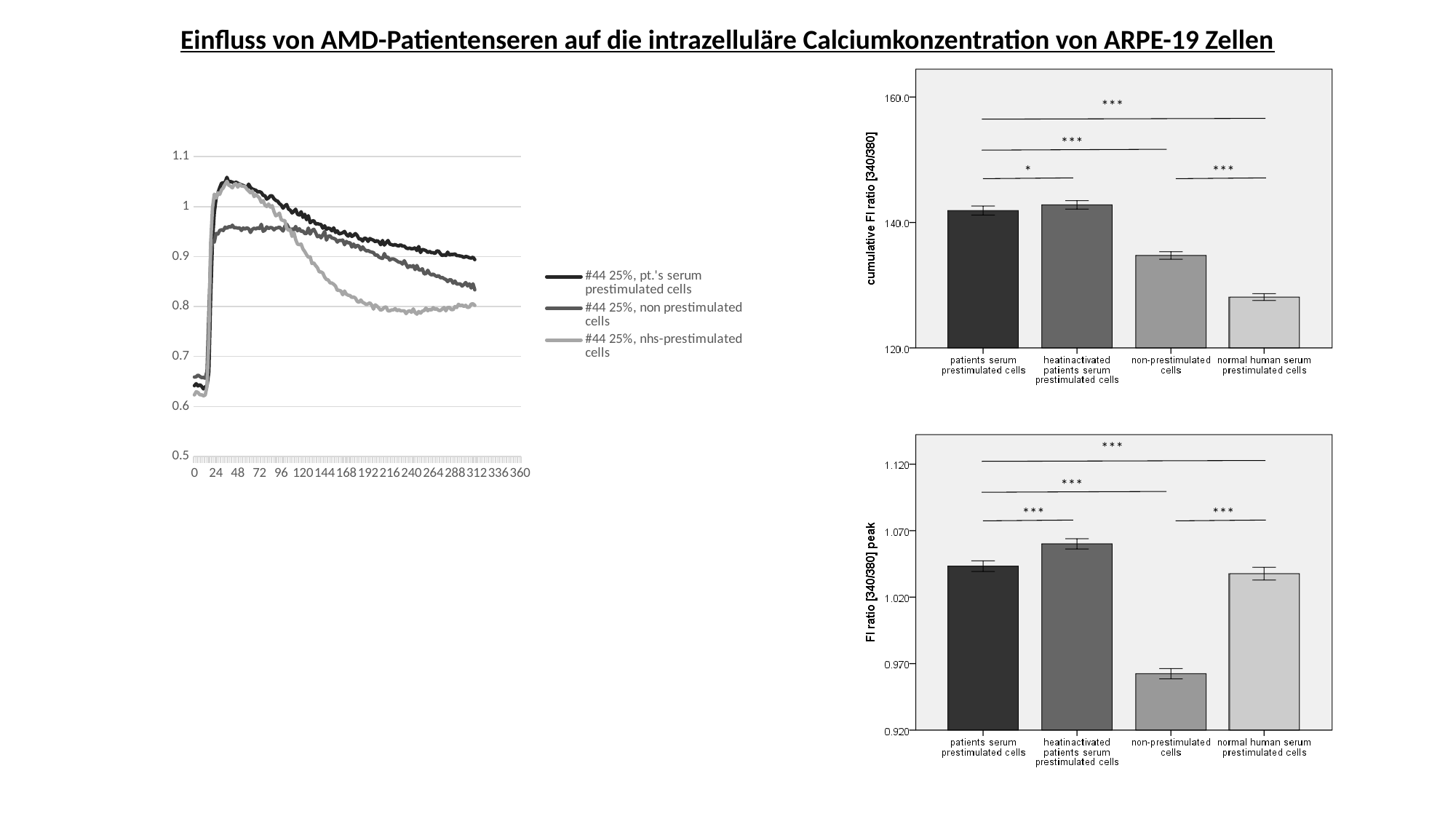
What kind of chart is the chart on the left of the slide? line chart In the top right 'cumulative FI ratio [340/380]' bar chart, is the value for 'non-prestimulated cells' greater or less than 140? less In the bottom right 'FI ratio [340/380] peak' bar chart, which category has the lowest value? non-prestimulated cells In the top right 'cumulative FI ratio [340/380]' bar chart, which is larger: 'non-prestimulated cells' or 'normal human serum prestimulated cells'? non-prestimulated cells In the top right 'cumulative FI ratio [340/380]' bar chart, which category has the lowest value? normal human serum prestimulated cells How many categories are shown in the top right 'cumulative FI ratio [340/380]' bar chart? 4 In the left line chart, is the value of the '#44 25%, nhs-prestimulated cells' series at x = 240 greater or less than 0.9? less How many series does the legend of the left line chart list? 3 In the bottom right 'FI ratio [340/380] peak' bar chart, is the value for 'normal human serum prestimulated cells' greater or less than 1.020? greater In the bottom right 'FI ratio [340/380] peak' bar chart, which category has the highest value? heatinactivated patients serum prestimulated cells In the left line chart, after the initial peak, do the values of the '#44 25%, nhs-prestimulated cells' series rise or fall along the x axis? fall What kind of chart is the top right chart with the y axis 'cumulative FI ratio [340/380]'? bar chart